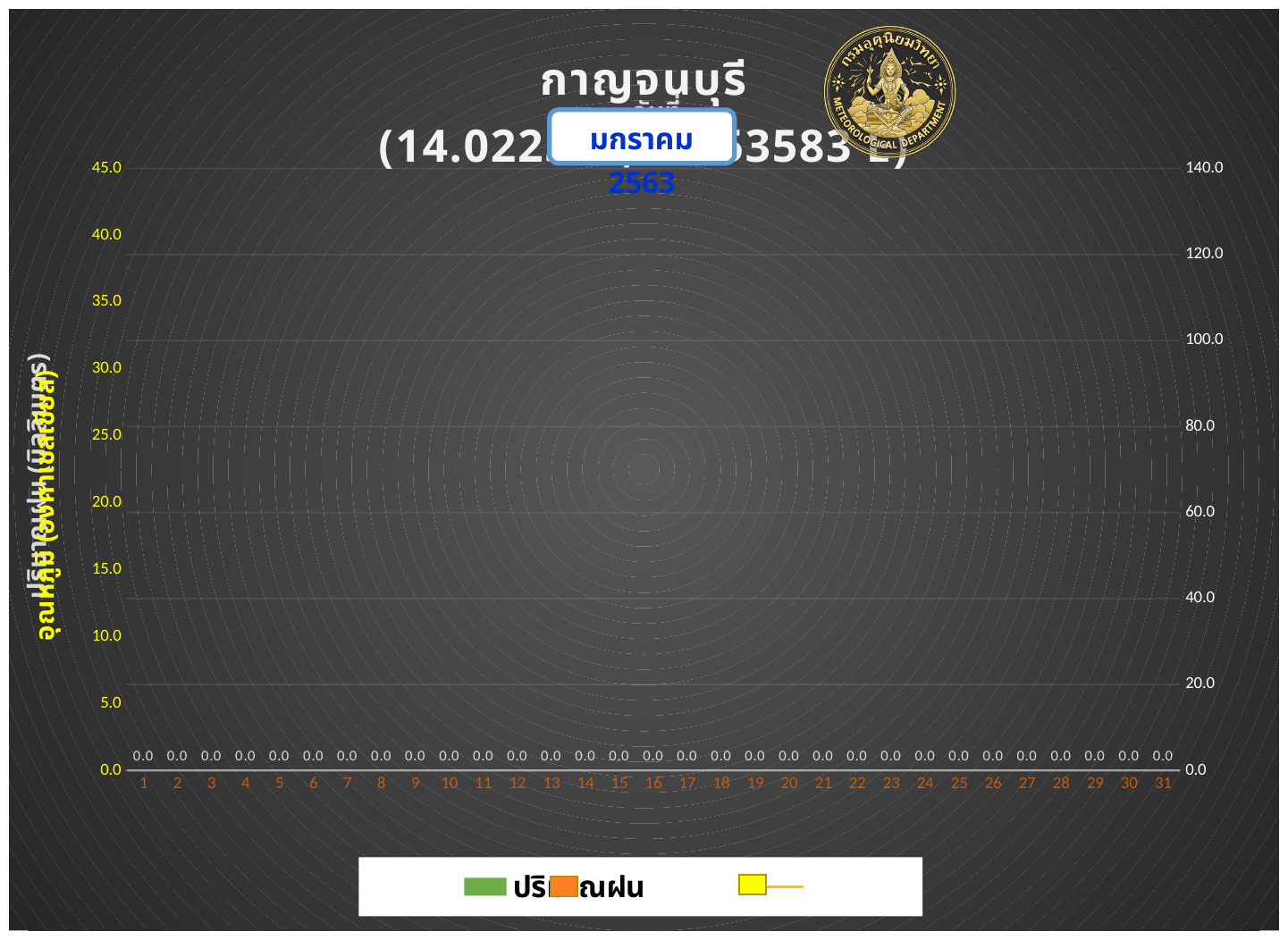
What is the difference between the labelled values for day 10 and day 20? 0.0 What is the value labelled for day 31 on the chart? 0.0 How many days are shown on the x axis of the chart? 31 What is the highest tick value shown on the right vertical axis? 140.0 What is the first day number shown on the x axis? 1 What is the last day number shown on the x axis? 31 What is the value labelled for day 15 on the chart? 0.0 What is the highest tick value shown on the left vertical axis? 45.0 What is the value labelled for day 1 on the chart? 0.0 Do the labelled values rise, fall, or stay flat from day 1 to day 31? stay flat